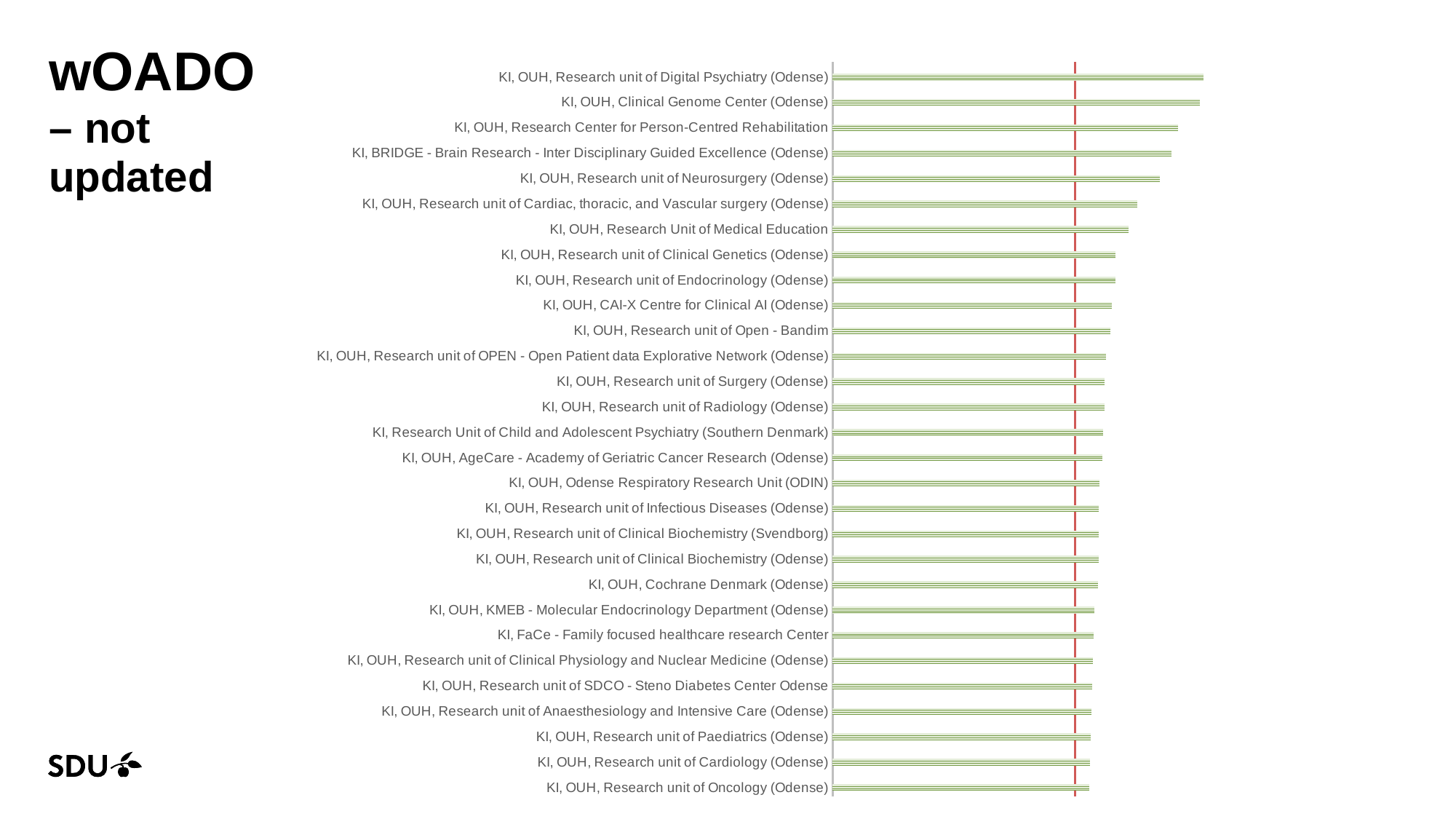
Which has the longer bar: KI, OUH, Clinical Genome Center (Odense) or KI, OUH, Research Unit of Medical Education? KI, OUH, Clinical Genome Center (Odense) Do the bar lengths increase or decrease going from the top of the chart to the bottom? Decrease Which has the longer bar: KI, OUH, Research unit of Digital Psychiatry (Odense) or KI, OUH, Research unit of Oncology (Odense)? KI, OUH, Research unit of Digital Psychiatry (Odense) What is the title text shown on the slide next to the chart? wOADO – not updated How many research units are listed as categories in the chart? 29 Which research unit is listed at the top of the chart? KI, OUH, Research unit of Digital Psychiatry (Odense) Which has the longer bar: KI, OUH, Research unit of Neurosurgery (Odense) or KI, OUH, Research unit of Cardiology (Odense)? KI, OUH, Research unit of Neurosurgery (Odense) What kind of chart is shown on the slide? Bar chart Which research unit has the longest bar in the chart? KI, OUH, Research unit of Digital Psychiatry (Odense)